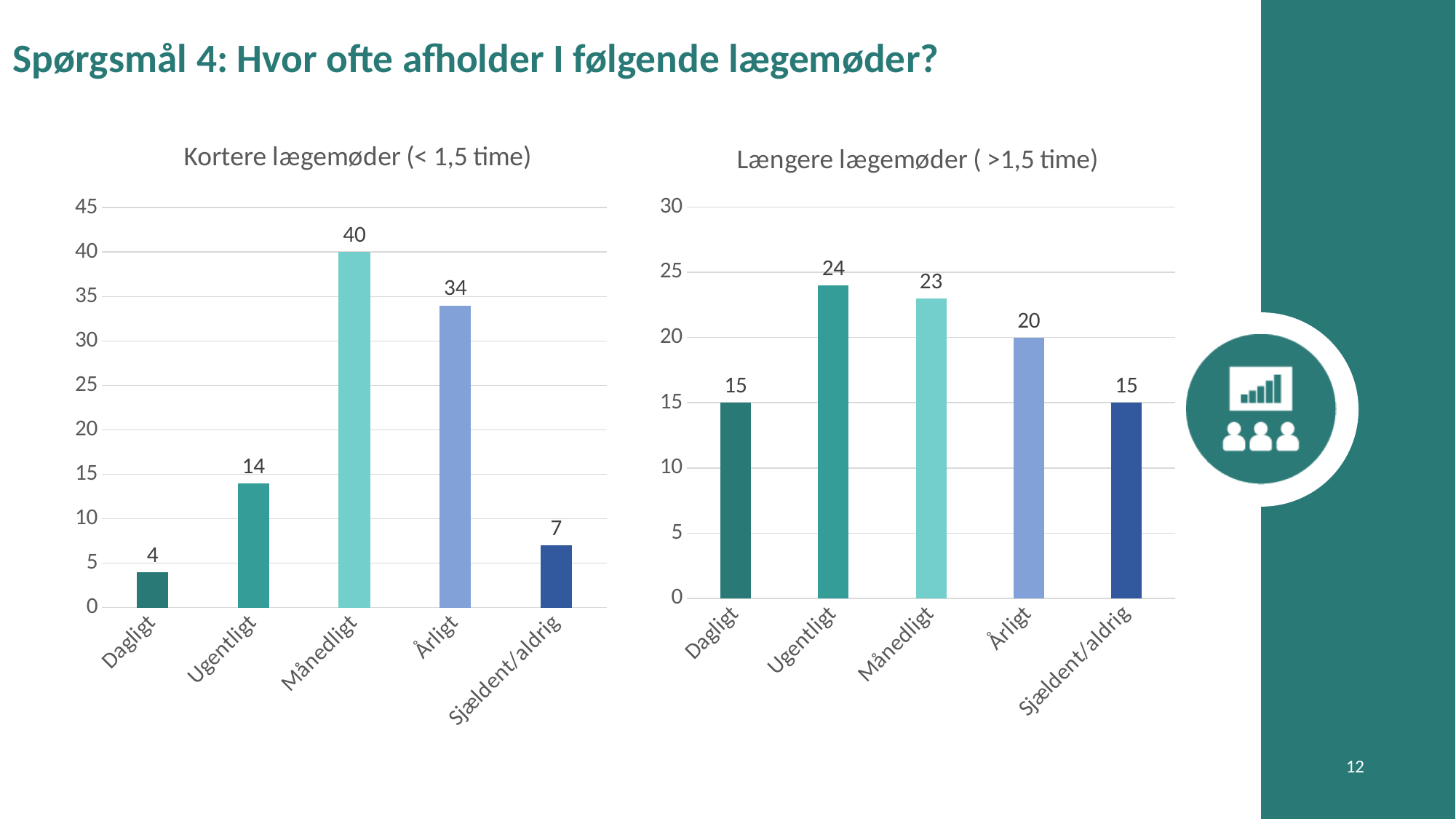
In the chart titled "Længere lægemøder ( >1,5 time)", what is the value for Ugentligt? 24 What kind of chart is the chart titled "Længere lægemøder ( >1,5 time)"? Bar chart How many categories are shown in the chart titled "Kortere lægemøder (< 1,5 time)"? 5 In the chart titled "Kortere lægemøder (< 1,5 time)", what is the difference between the values for Månedligt and Årligt? 6 In the chart titled "Kortere lægemøder (< 1,5 time)", which category has the lowest value? Dagligt In the chart titled "Kortere lægemøder (< 1,5 time)", which is larger, the value for Ugentligt or the value for Sjældent/aldrig? Ugentligt In the chart titled "Kortere lægemøder (< 1,5 time)", what is the value for Sjældent/aldrig? 7 In the chart titled "Længere lægemøder ( >1,5 time)", which category has the highest value? Ugentligt In the chart titled "Længere lægemøder ( >1,5 time)", what is the difference between the values for Ugentligt and Årligt? 4 What is the title of the chart on the right side of the slide? Længere lægemøder ( >1,5 time) In the chart titled "Kortere lægemøder (< 1,5 time)", what is the value for Månedligt? 40 In the chart titled "Længere lægemøder ( >1,5 time)", is the value for Årligt greater or less than 15? greater